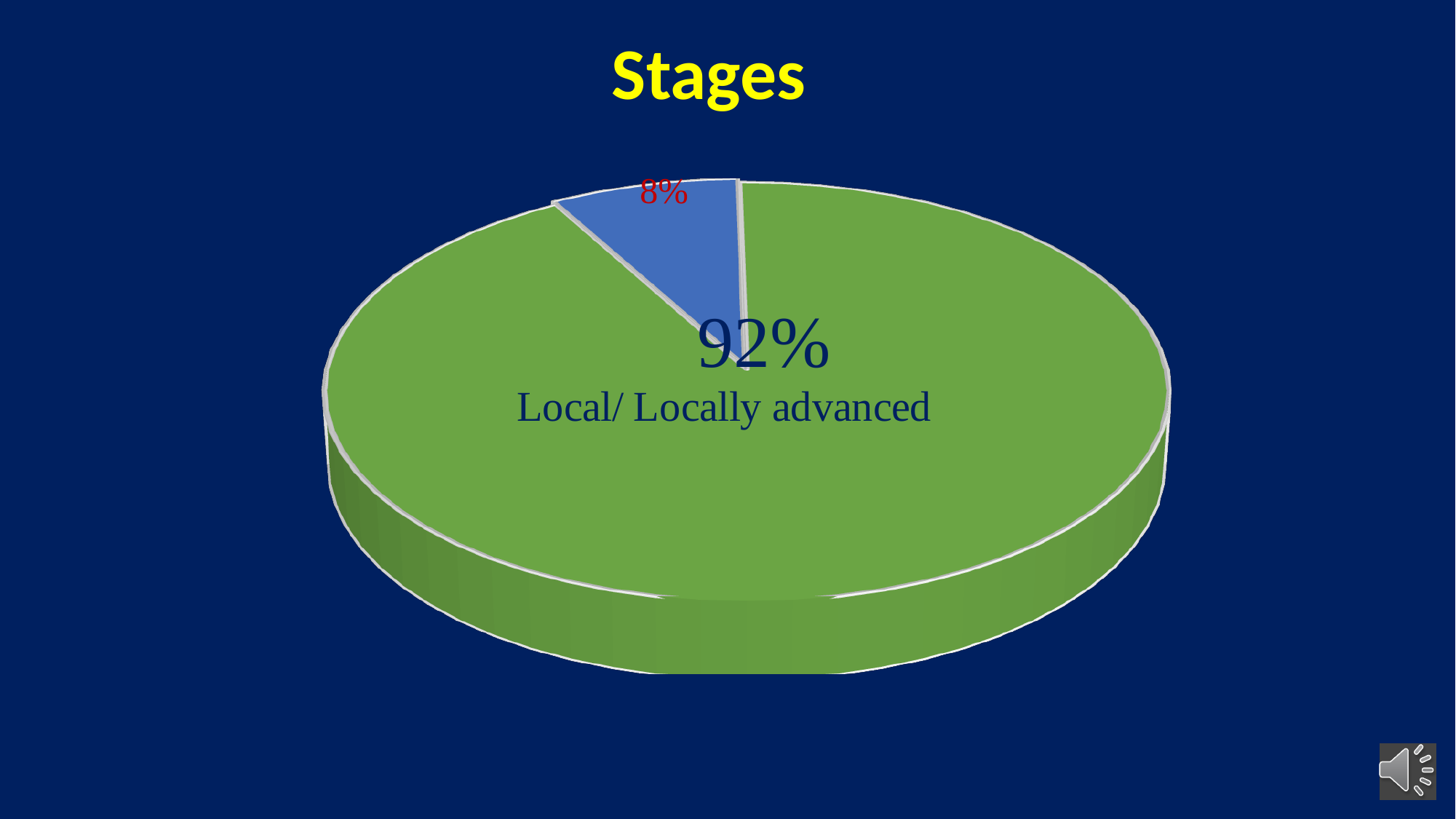
What colour is the Local/ Locally advanced slice? Green What is the percentage shown on the smallest slice of the pie? 8% What is the title of the chart? Stages Is the share for Local/ Locally advanced greater or less than 50%? greater What is the difference in percentage points between the Local/ Locally advanced slice and the blue slice? 84 percentage points What share of the pie does the blue slice represent? 8% What kind of chart is shown on the slide? Pie chart What share of the pie is Local/ Locally advanced? 92% How many slices does the pie chart have? 2 Which slice of the pie is the largest? Local/ Locally advanced Which is larger: the green slice or the blue slice? The green slice